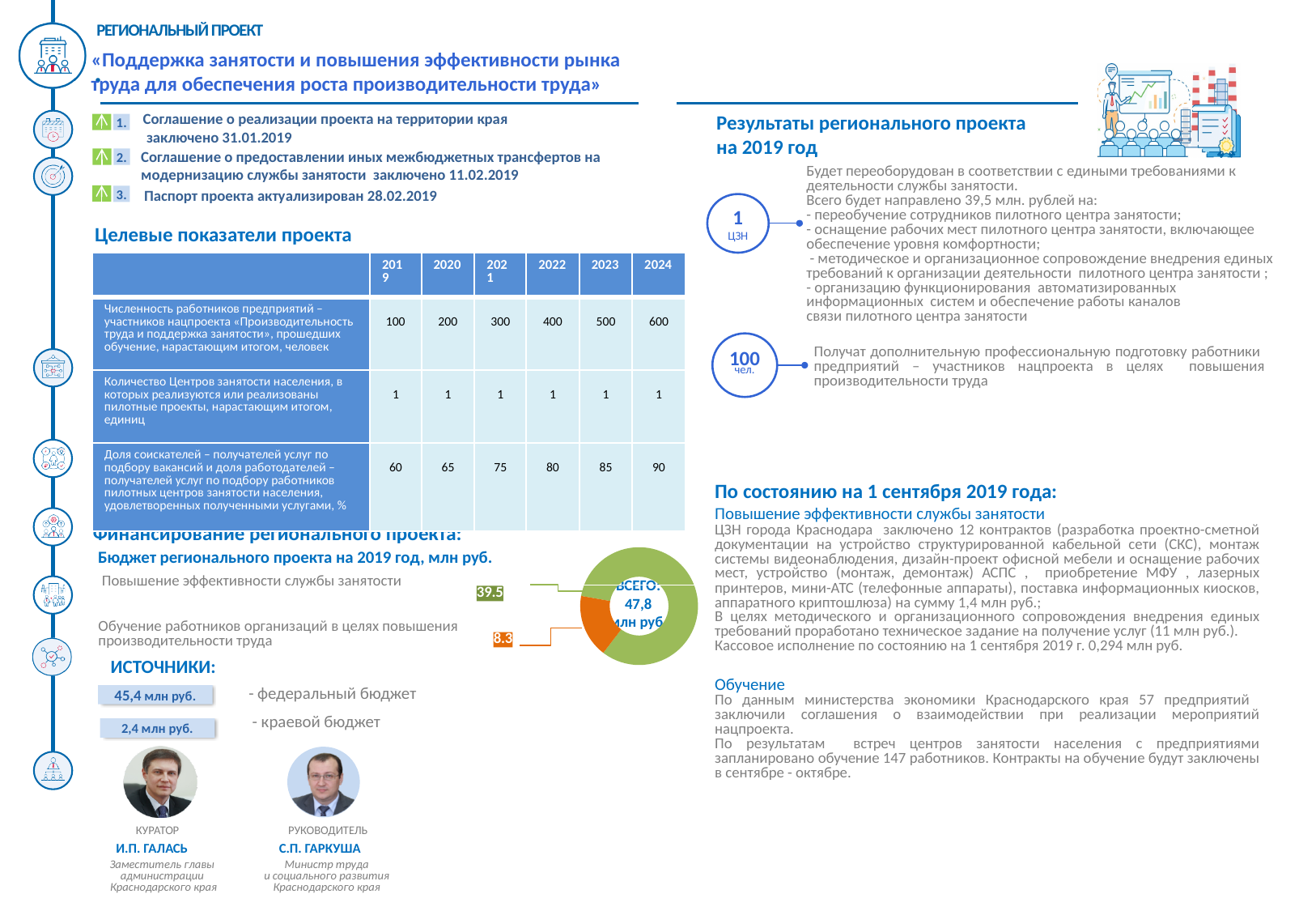
What colour is the slice for the value 8.3 in the budget chart? orange Which budget item has the largest slice in the chart? Повышение эффективности службы занятости Which is larger in the budget chart: the value for «Повышение эффективности службы занятости» or for «Обучение работников организаций»? Повышение эффективности службы занятости How many slices does the budget chart have? 2 What total is printed in the centre of the budget chart? ВСЕГО: 47,8 млн руб What is the difference between the two values shown in the budget chart (39.5 and 8.3)? 31.2 What colour is the slice for the value 39.5 in the budget chart? green Which budget item has the smallest slice in the chart? Обучение работников организаций в целях повышения производительности труда What is the value shown for «Повышение эффективности службы занятости» in the budget chart? 39.5 What kind of chart is used to show the 2019 regional project budget? doughnut chart What is the value shown for «Обучение работников организаций в целях повышения производительности труда» in the budget chart? 8.3